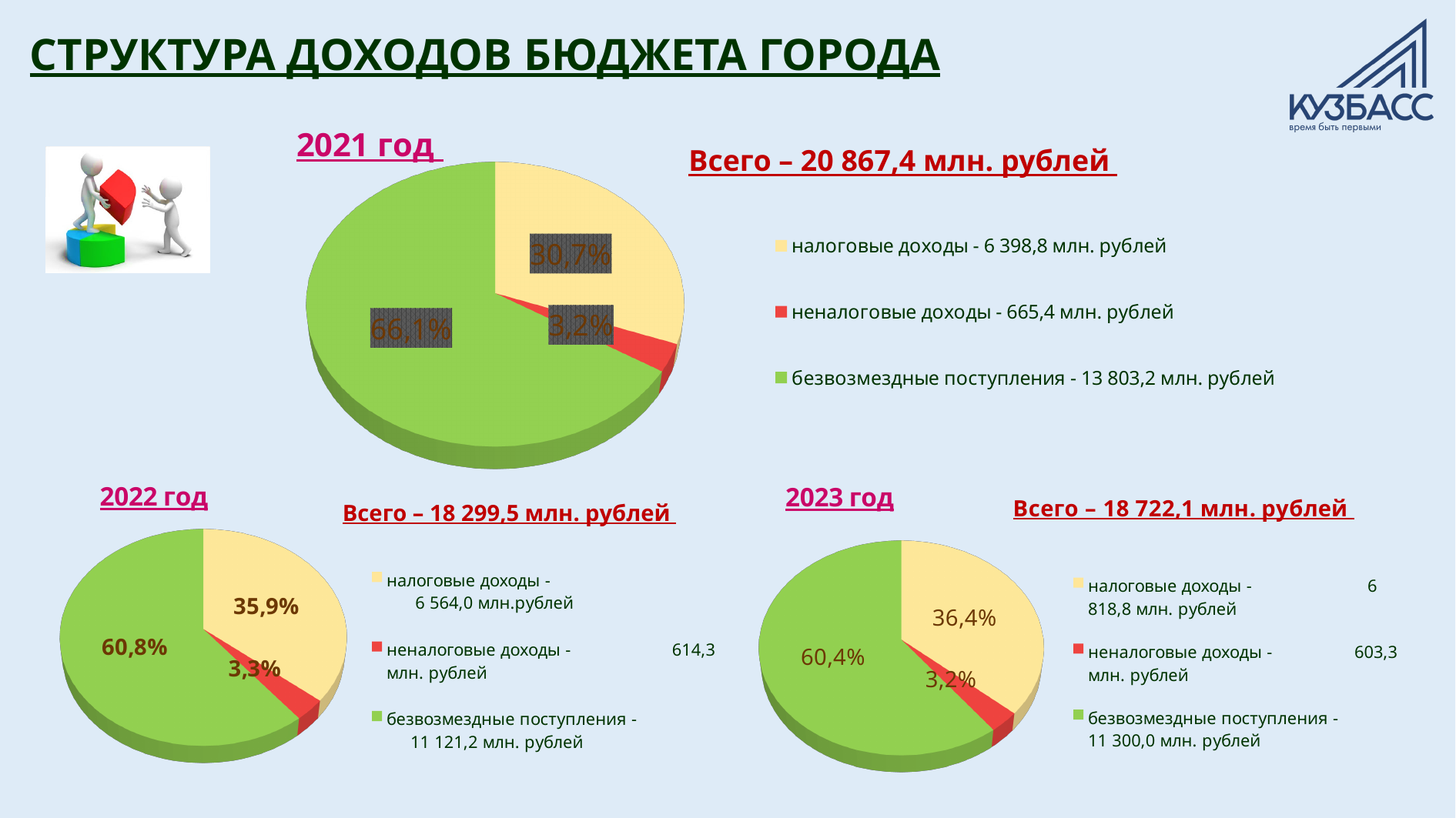
Which is larger: the налоговые доходы share in the 2022 год pie chart or in the 2023 год pie chart? 2023 год In the 2022 год pie chart, which category has the smallest slice? неналоговые доходы In the 2023 год pie chart, which category has the largest slice? безвозмездные поступления In the 2021 год pie chart, what share is labelled for безвозмездные поступления? 66,1% In the 2021 год pie chart, what share is labelled for налоговые доходы? 30,7% In the 2021 год pie chart, what is the difference in percentage points between the безвозмездные поступления slice and the налоговые доходы slice? 35,4 In the 2023 год pie chart, what share is labelled for налоговые доходы? 36,4% What total (Всего) is shown for the 2023 год chart? 18 722,1 млн. рублей How many slices does the 2022 год pie chart have? 3 In the 2022 год pie chart, what share is labelled for неналоговые доходы? 3,3% According to the legend of the 2021 год chart, what is the amount of безвозмездные поступления? 13 803,2 млн. рублей What type of chart is used for 2021 год? pie chart